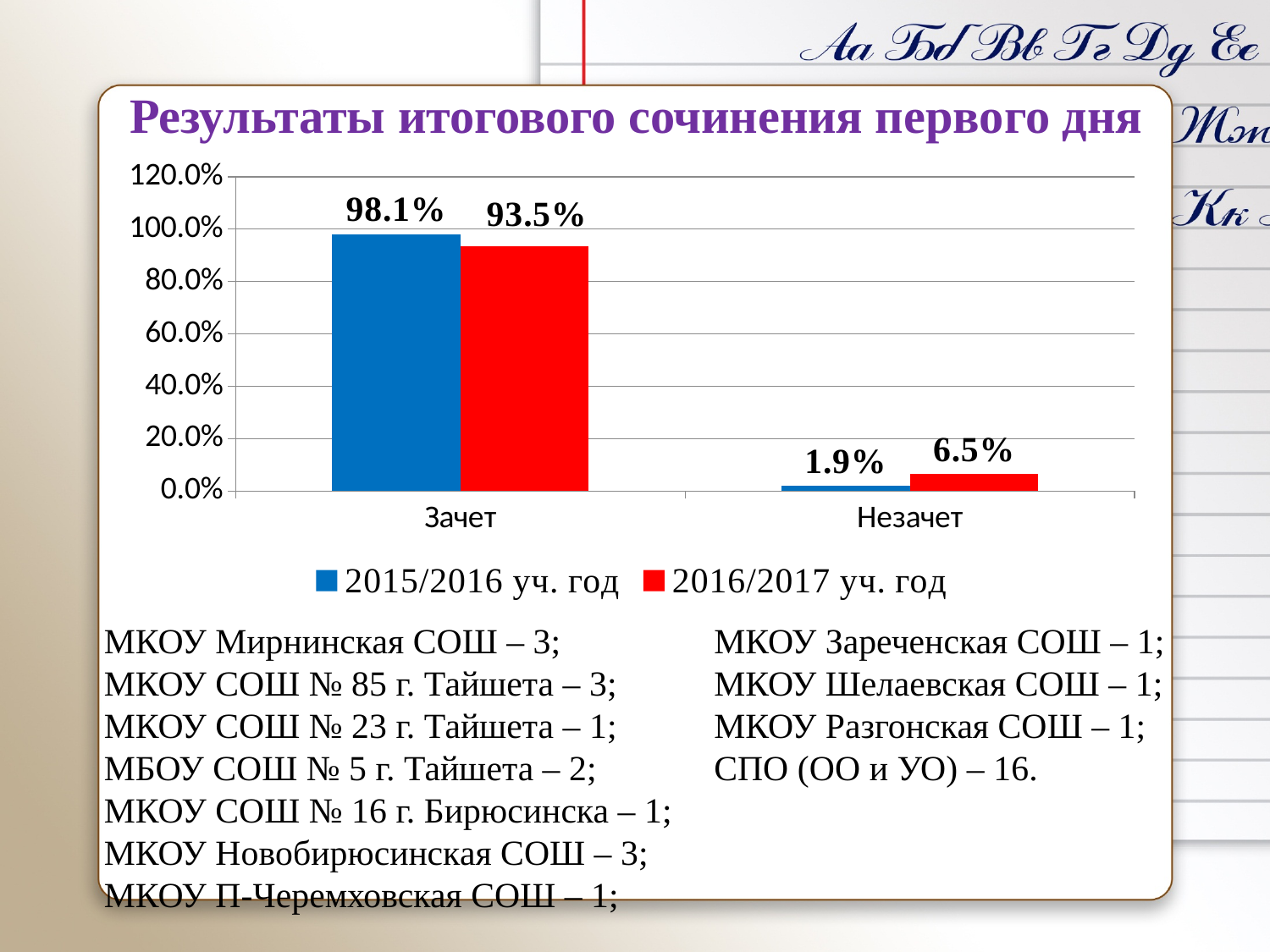
What is the value for Незачет in the 2016/2017 уч. год series? 6.5% Which series has the larger value for Незачет, 2015/2016 уч. год or 2016/2017 уч. год? 2016/2017 уч. год What is the value for Незачет in the 2015/2016 уч. год series? 1.9% What is the difference between the 2015/2016 уч. год and 2016/2017 уч. год values for Зачет? 4.6% What is the value for Зачет in the 2015/2016 уч. год series? 98.1% Which category has the highest value in the 2016/2017 уч. год series? Зачет How many series does the legend list? 2 What kind of chart is shown on the slide? Bar chart What is the difference between the 2016/2017 уч. год and 2015/2016 уч. год values for Незачет? 4.6% Which category has the lowest value in the 2015/2016 уч. год series? Незачет What is the value for Зачет in the 2016/2017 уч. год series? 93.5% How many categories are shown on the x axis? 2